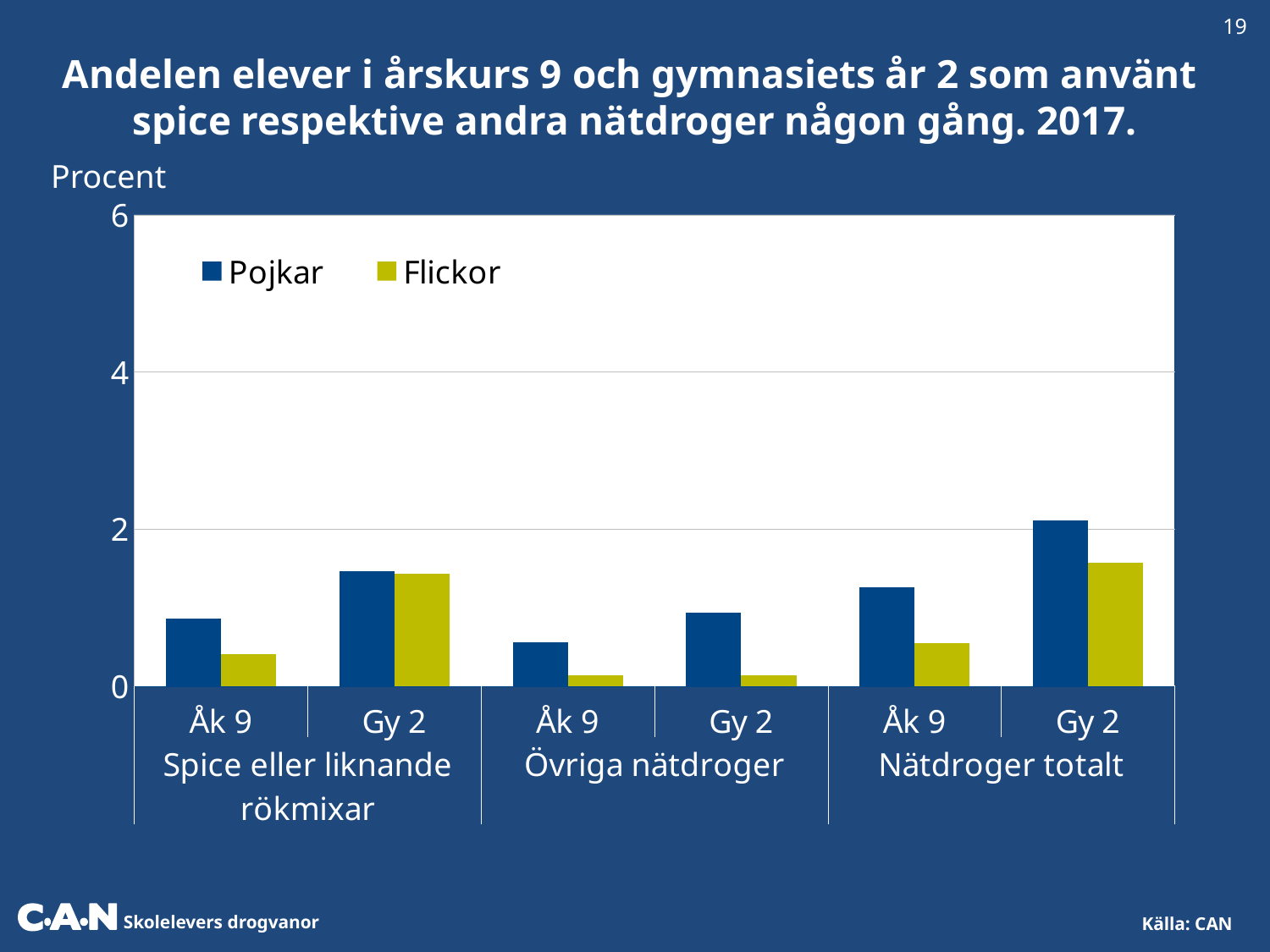
For which category is the Flickor value highest? Gy 2, Nätdroger totalt How many series does the legend list? 2 For Åk 9 under Övriga nätdroger, which is larger: Pojkar or Flickor? Pojkar For which category is the Pojkar value highest? Gy 2, Nätdroger totalt How many category groups are shown along the x axis? 3 What kind of chart is shown on the slide? Bar chart Which two series are listed in the legend? Pojkar and Flickor What label is shown on the vertical axis? Procent Is the Flickor value for Gy 2 under Nätdroger totalt greater or less than 2? less For Åk 9 under Spice eller liknande rökmixar, which is larger: Pojkar or Flickor? Pojkar For which category is the Pojkar value lowest? Åk 9, Övriga nätdroger Is the Pojkar value for Gy 2 under Nätdroger totalt greater or less than 2? greater